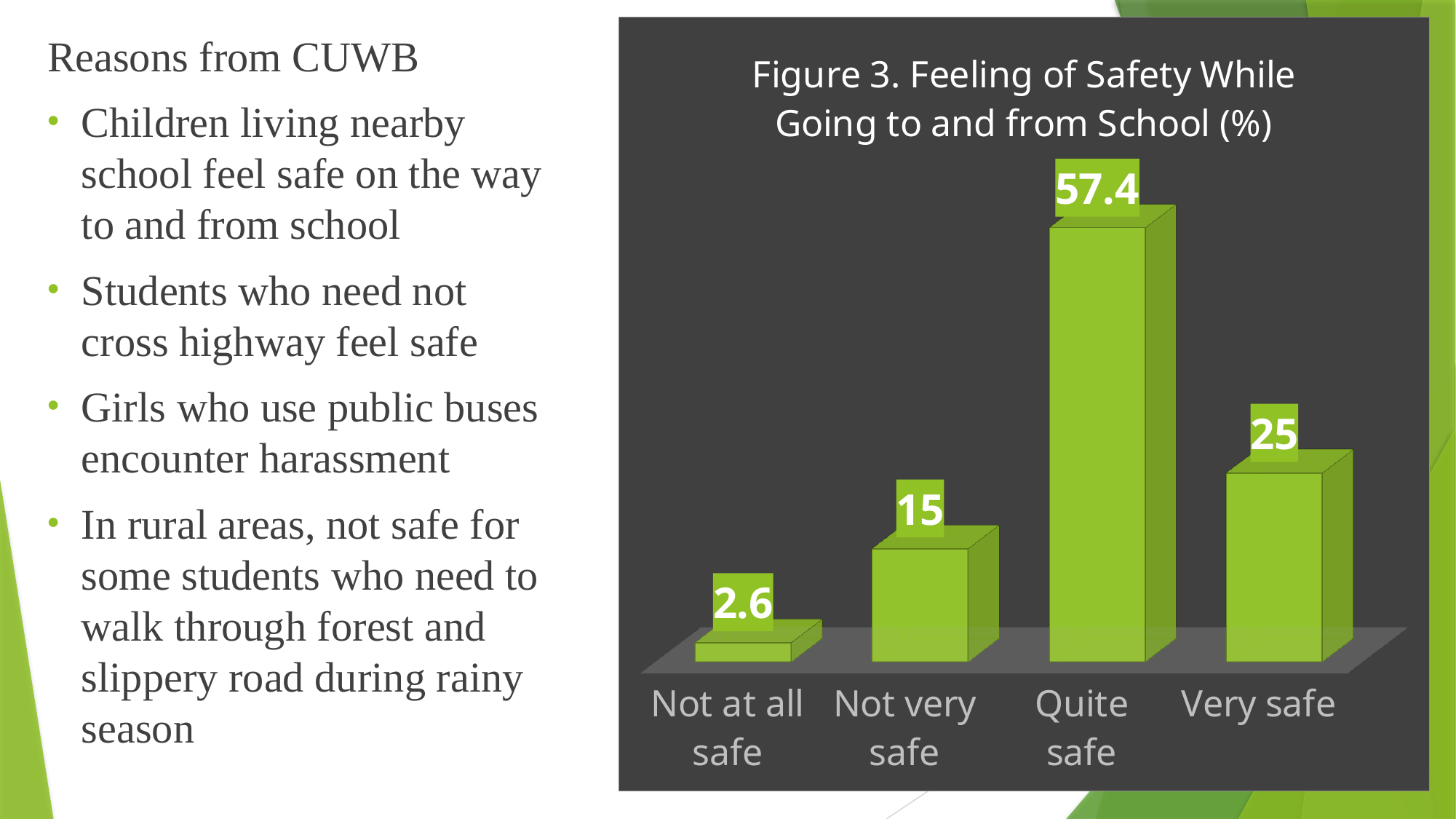
What is the value for "Very safe"? 25 What kind of chart is shown on the slide? Bar chart How many categories are shown in the chart? 4 What is the value for "Not very safe"? 15 Which category has the highest value? Quite safe What is the title of the chart? Figure 3. Feeling of Safety While Going to and from School (%) What is the value for "Quite safe"? 57.4 Which category has the lowest value? Not at all safe What is the difference between the values for "Quite safe" and "Very safe"? 32.4 Which is larger, the value for "Very safe" or the value for "Not very safe"? Very safe What is the difference between the values for "Not very safe" and "Not at all safe"? 12.4 What is the value for "Not at all safe"? 2.6